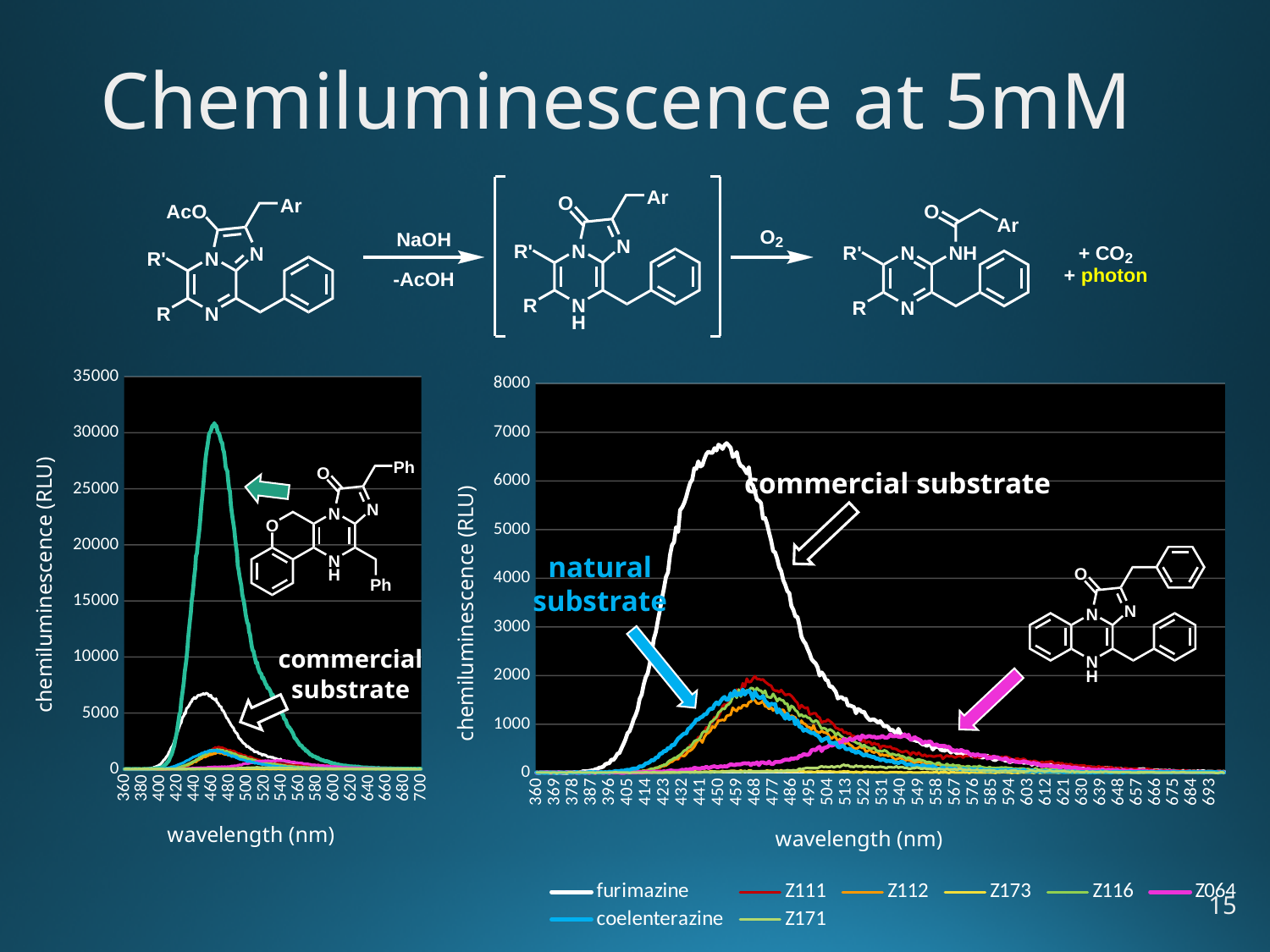
In the right-hand chart, is the peak value of the furimazine curve greater or less than 7000? less In the right-hand chart, which series reaches the highest peak? furimazine In the right-hand chart, is the peak value of the Z064 curve greater or less than 1000? less In the left-hand chart, is the peak of the green curve greater or less than 25000? greater How many series does the legend of the right-hand chart list? 8 What kind of chart is the right-hand chart on the slide? line chart What is the label on the y axis of the right-hand chart? chemiluminescence (RLU) In the right-hand chart, which curve has the larger peak, furimazine or coelenterazine? furimazine What is the label on the x axis of the left-hand chart? wavelength (nm)